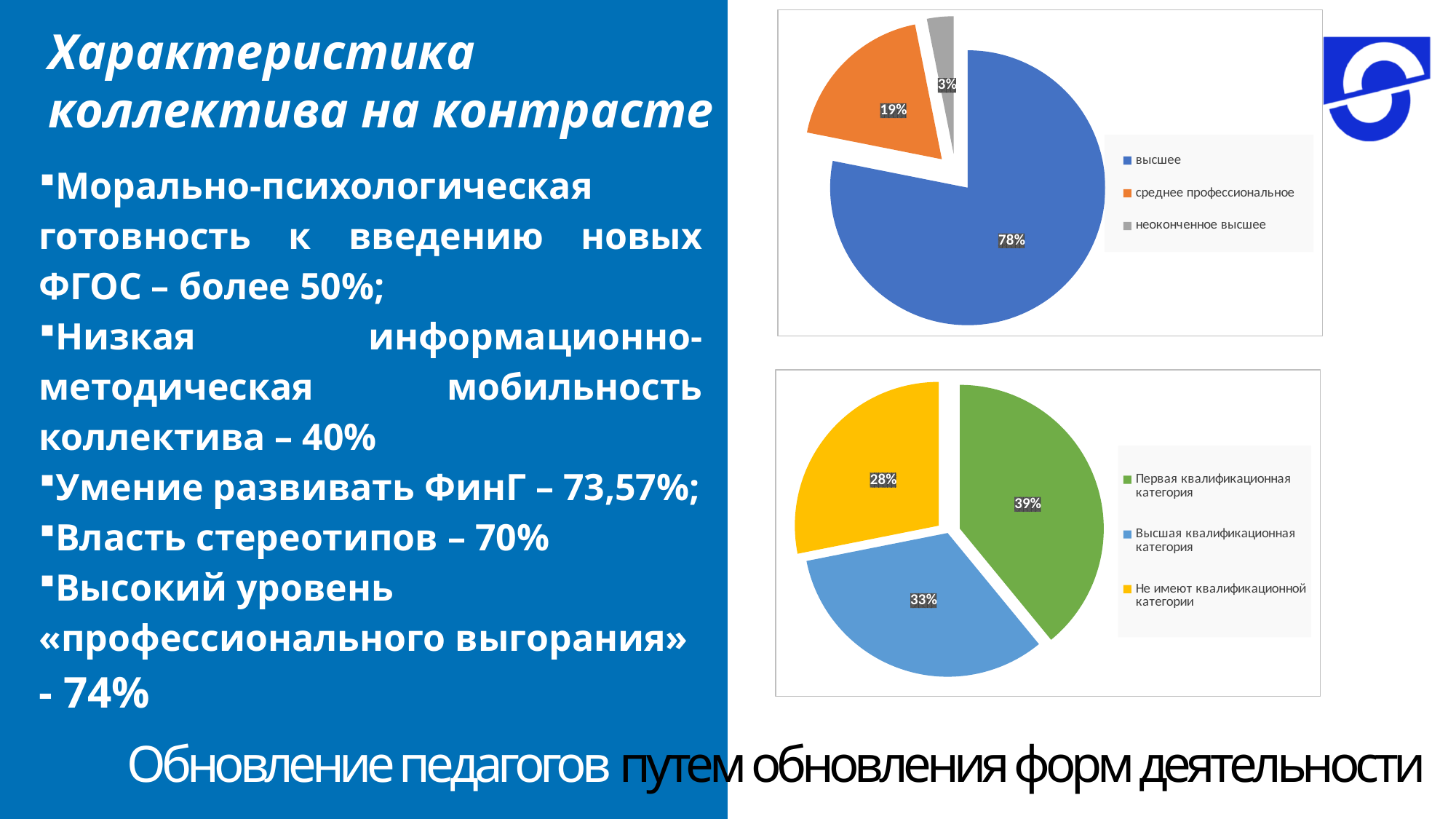
In the bottom pie chart, which category has the smallest slice? Не имеют квалификационной категории In the top pie chart, which category has the largest slice? высшее What type of chart is the bottom chart on the slide? Pie chart In the bottom pie chart, which is larger: "Первая квалификационная категория" or "Не имеют квалификационной категории"? Первая квалификационная категория In the top pie chart, what share is labelled for "высшее"? 78% In the top pie chart, what is the difference between the shares for "высшее" and "среднее профессиональное"? 59% In the bottom pie chart, what share is labelled for "Первая квалификационная категория"? 39% In the bottom pie chart, what share is labelled for "Высшая квалификационная категория"? 33% In the top pie chart, what share is labelled for "среднее профессиональное"? 19% How many slices does the top pie chart have? 3 In the top pie chart, which category has the smallest slice? неоконченное высшее In the top pie chart, what share is labelled for "неоконченное высшее"? 3%